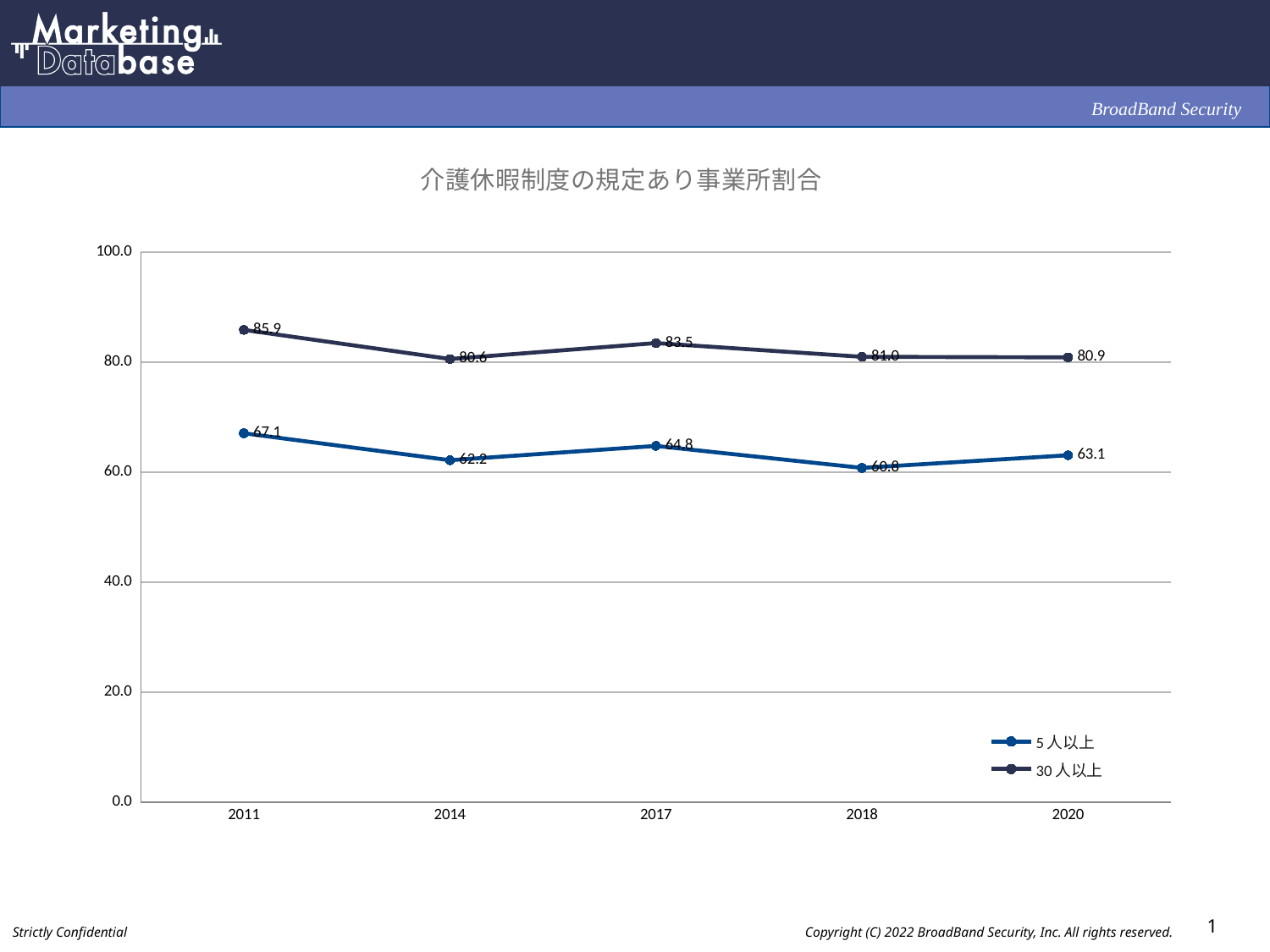
What is the value for 5人以上 in 2018? 60.8 Which series has the larger value in 2014, 5人以上 or 30人以上? 30人以上 What is the title of the chart? 介護休暇制度の規定あり事業所割合 What is the value for 5人以上 in 2011? 67.1 In which year is the value for 5人以上 lowest? 2018 How many series does the legend list? 2 What is the difference between the 30人以上 and 5人以上 values in 2011? 18.8 In which year is the value for 30人以上 highest? 2011 What type of chart is shown on the slide? line chart What is the value for 30人以上 in 2020? 80.9 How many years are shown on the x axis? 5 What is the value for 30人以上 in 2017? 83.5